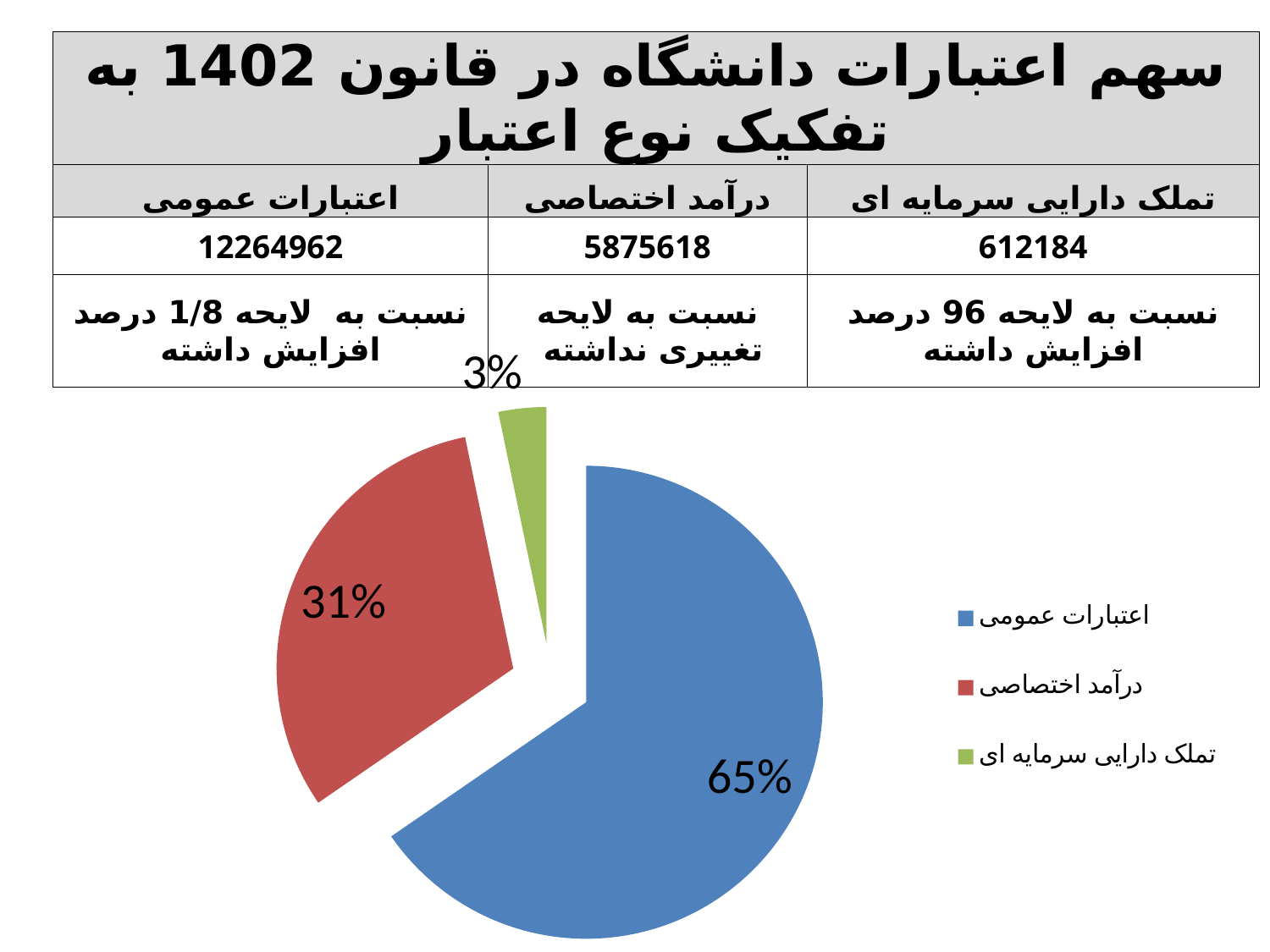
What share of the pie does اعتبارات عمومی hold? 65% What share of the pie does درآمد اختصاصی hold? 31% What share of the pie does تملک دارایی سرمایه ای hold? 3% Which category has the largest slice of the pie? اعتبارات عمومی What is the difference in percentage points between the اعتبارات عمومی slice and the درآمد اختصاصی slice? 34 Which category has the smallest slice of the pie? تملک دارایی سرمایه ای How many entries does the legend list? 3 Which slice is larger, درآمد اختصاصی or تملک دارایی سرمایه ای? درآمد اختصاصی How many slices does the pie chart have? 3 What colour is the slice for تملک دارایی سرمایه ای? green What colour is the slice for درآمد اختصاصی? red What kind of chart is shown on the slide? pie chart